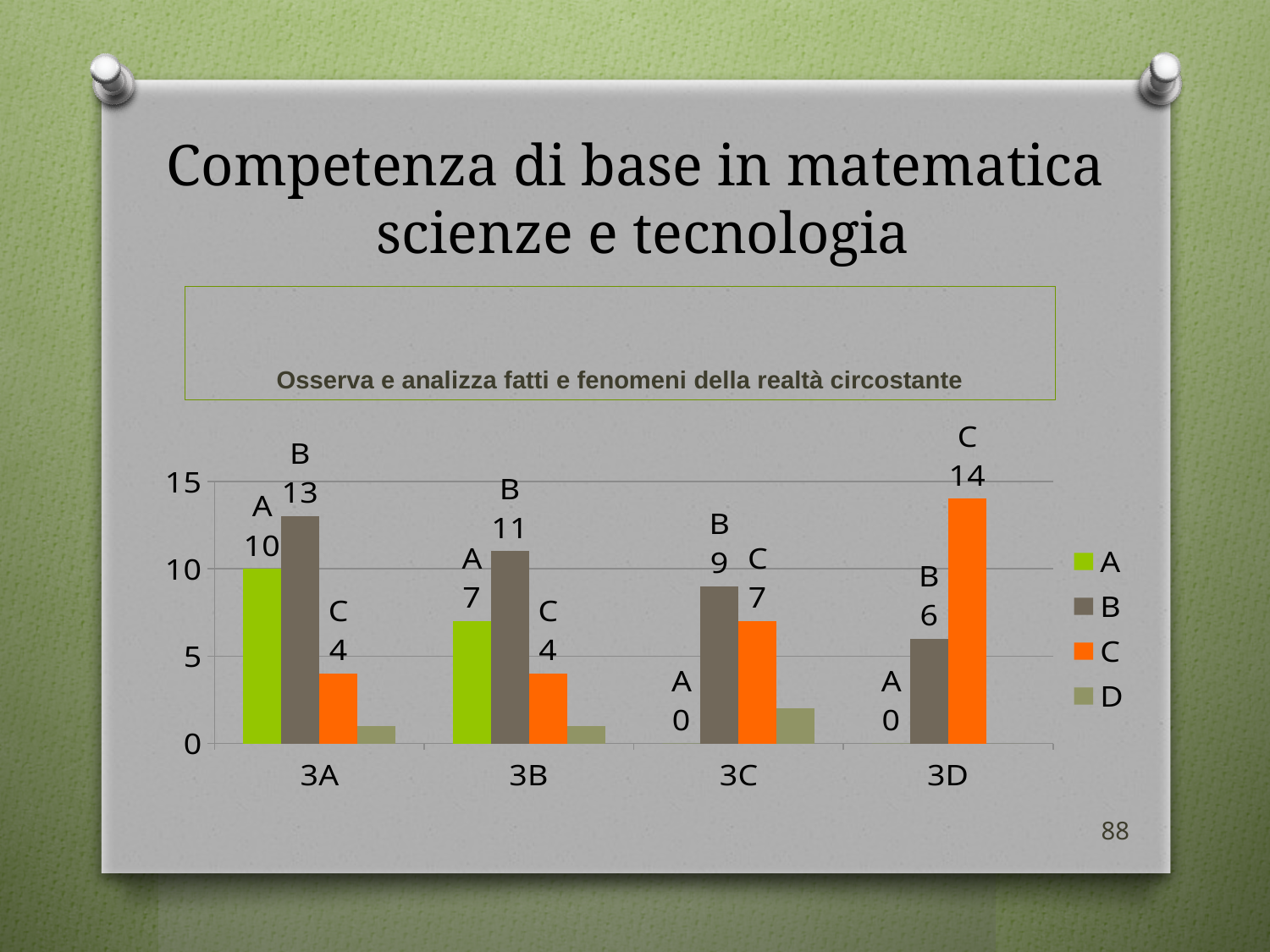
For class 3C, which is larger: series B or series C? B Do the values of series B rise or fall from 3A to 3D? fall What is the value of series A for class 3C? 0 Is the value of series D for class 3A greater or less than 5? less What is the value of series A for class 3B? 7 What is the difference between the series B values for 3A and 3B? 2 How many series does the legend list? 4 What kind of chart is shown on the slide? bar chart What is the value of series B for class 3A? 13 How many classes are shown on the x axis? 4 What is the value of series C for class 3D? 14 Which class has the highest value for series C? 3D